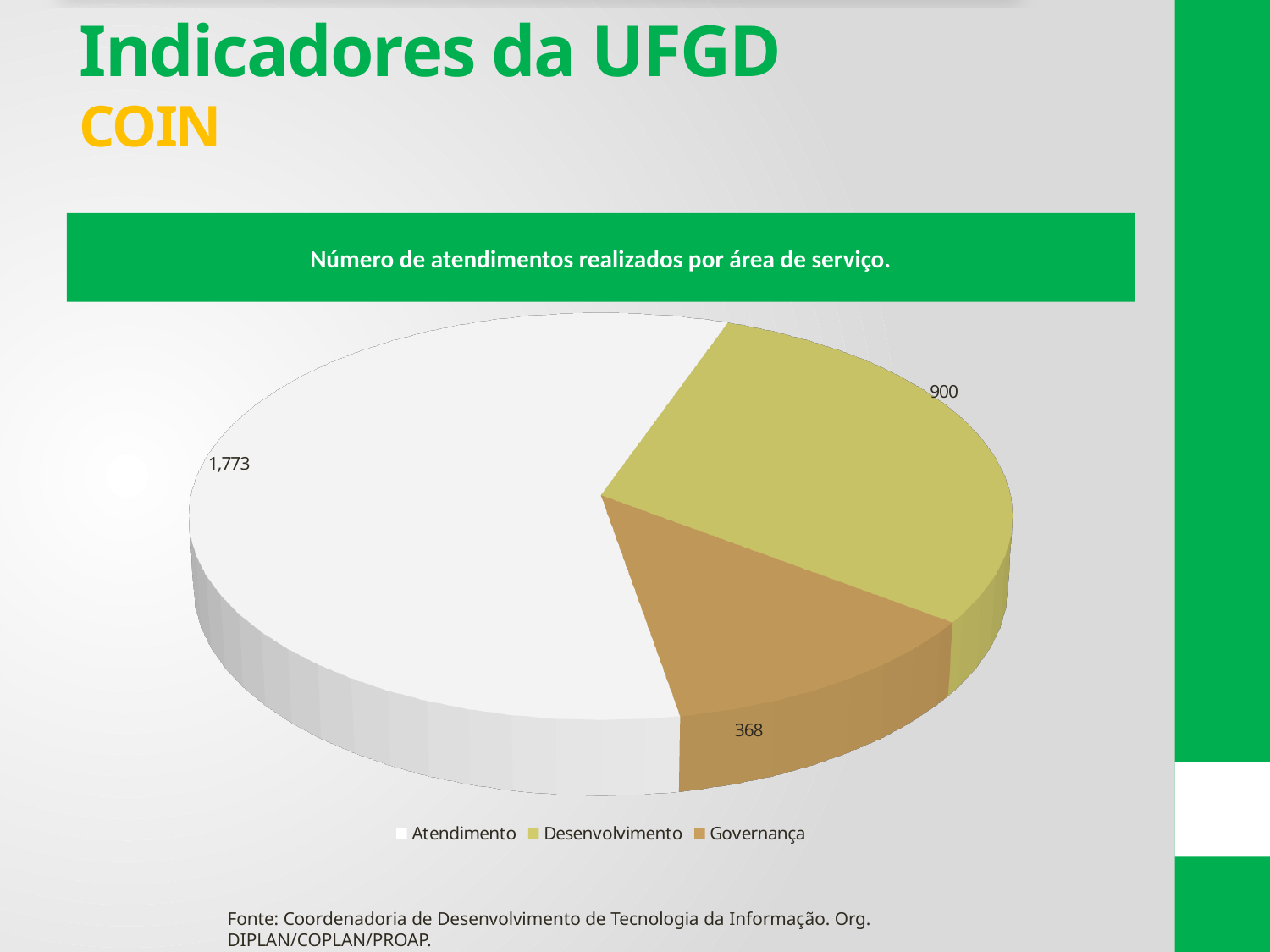
What is the difference between the values for Atendimento and Desenvolvimento? 873 What is the value for Desenvolvimento? 900 Which service area has the highest number of atendimentos? Atendimento What is the title of the chart? Número de atendimentos realizados por área de serviço. What is the total of all three slices in the pie chart? 3,041 What is the value for Atendimento? 1,773 Which service area has the lowest number of atendimentos? Governança Which is larger, the value for Desenvolvimento or the value for Governança? Desenvolvimento What is the value for Governança? 368 What kind of chart is shown on the slide? Pie chart What is the difference between the values for Desenvolvimento and Governança? 532 How many slices does the pie chart have? 3